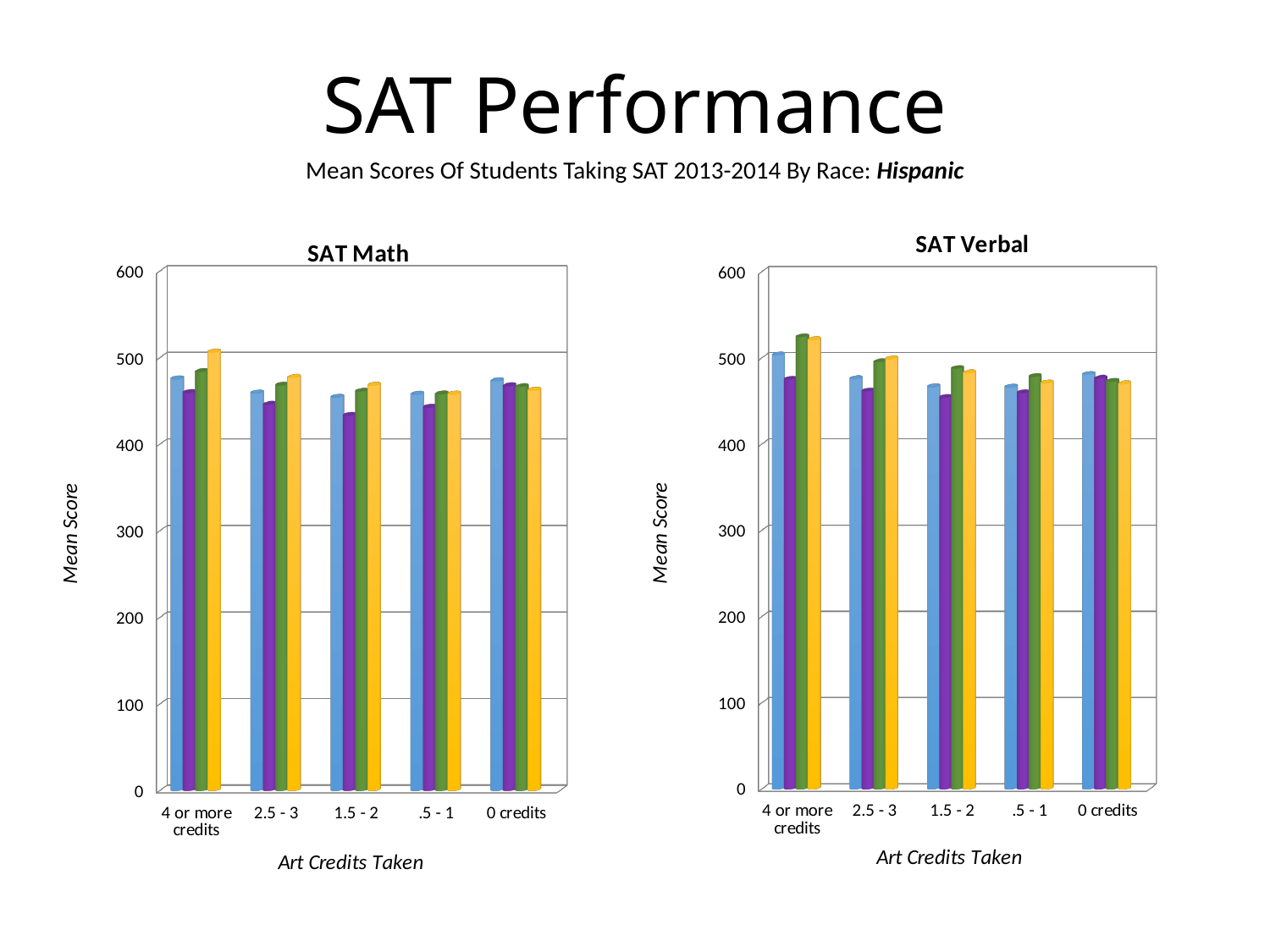
In the SAT Math chart, is the value of the purple bar for 1.5 - 2 credits greater or less than 500? less How many categories are shown on the x axis of the SAT Verbal chart? 5 In the SAT Math chart, is the value of the blue bar for 0 credits greater or less than 400? greater What is the label on the y axis of the SAT Math chart? Mean Score In the SAT Math chart, for 4 or more credits, which bar is taller: the yellow bar or the purple bar? the yellow bar What kind of chart is the SAT Math chart? bar chart How many bars are plotted for each category in the SAT Math chart? 4 What is the label on the x axis of the SAT Verbal chart? Art Credits Taken In the SAT Math chart, which category contains the tallest bar? 4 or more credits In the SAT Verbal chart, which category contains the tallest bar? 4 or more credits In the SAT Verbal chart, is the value of the green bar for 4 or more credits greater or less than 500? greater In the SAT Verbal chart, for 1.5 - 2 credits, which bar is taller: the green bar or the purple bar? the green bar